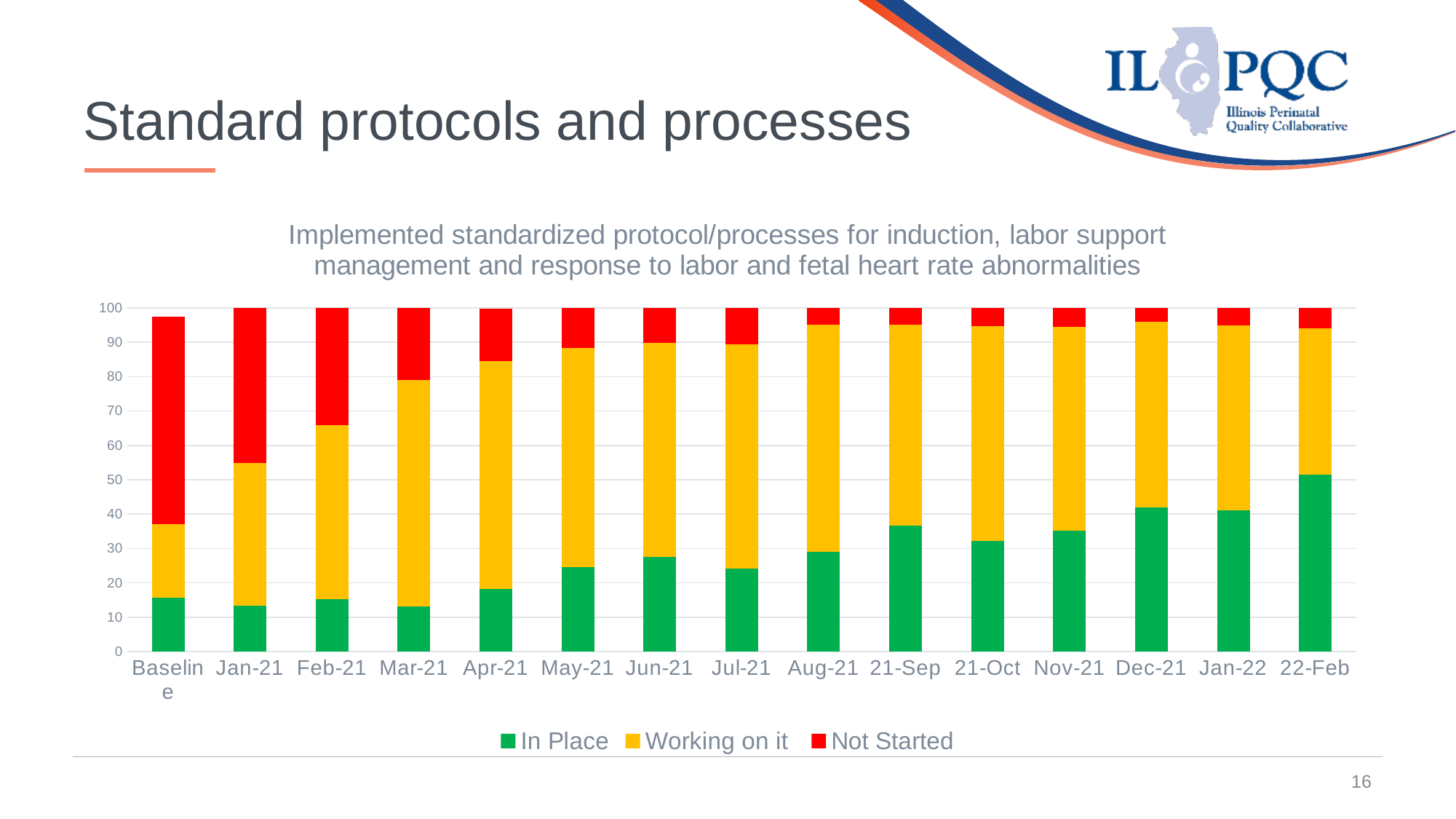
Does the 'In Place' series generally rise or fall from Baseline to 22-Feb? rise What kind of chart is shown on the slide? stacked bar chart Is the 'Not Started' value for Baseline greater or less than 50? greater Is the 'In Place' value for Baseline greater or less than 20? less How many series does the legend list? 3 Is the 'In Place' value for 21-Sep greater or less than 30? greater How many time-period categories are shown along the x axis? 15 Which category has the largest 'Not Started' segment? Baseline Which category has the largest 'In Place' segment? 22-Feb What are the three series named in the legend? In Place, Working on it, Not Started Which colour represents the 'Not Started' series? red